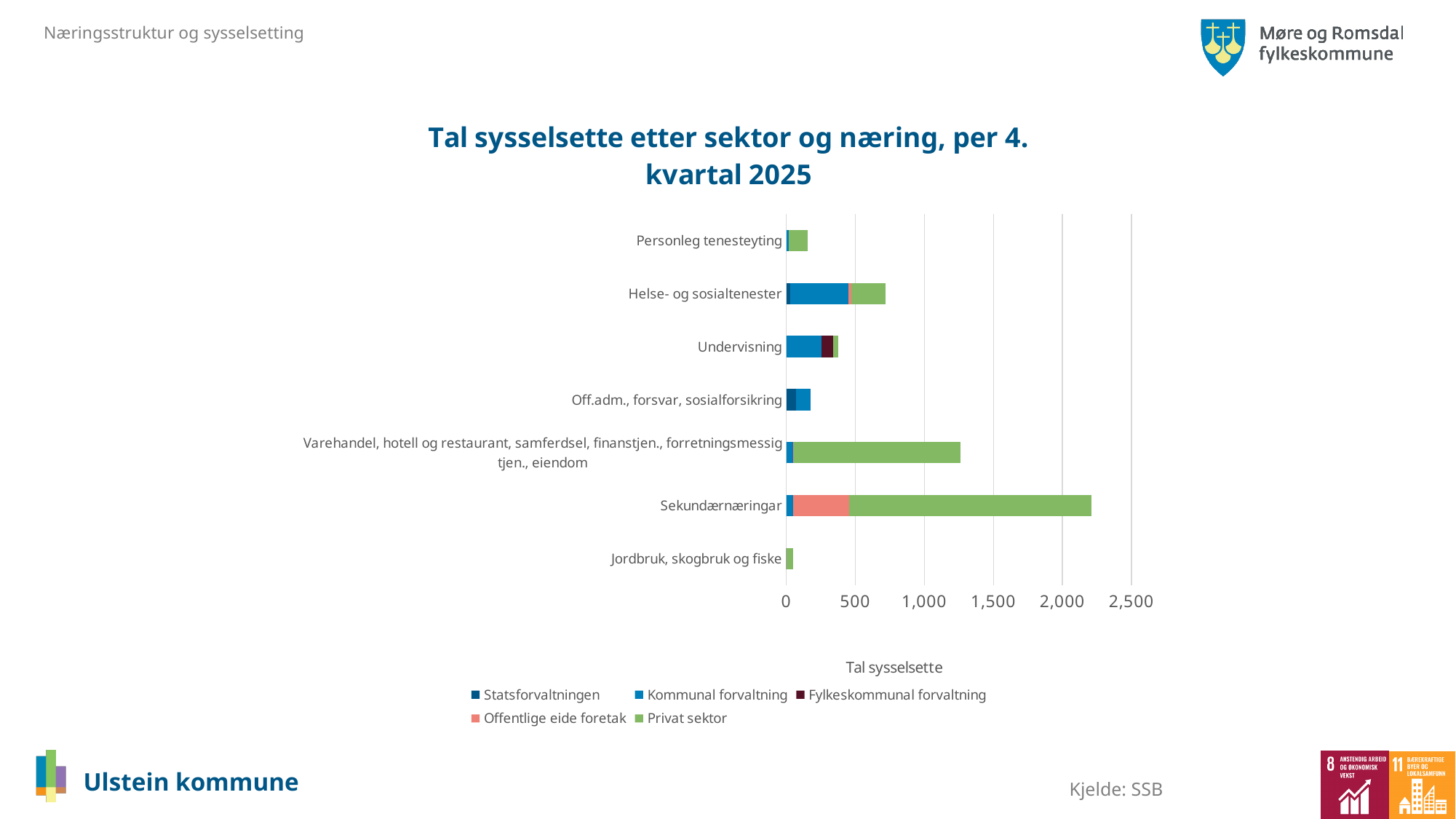
Is the total value for Varehandel, hotell og restaurant, samferdsel, finanstjen., forretningsmessig tjen., eiendom greater or less than 1,000? greater What is the title of the chart? Tal sysselsette etter sektor og næring, per 4. kvartal 2025 What kind of chart is shown on the slide? Stacked bar chart Which category has the longest total bar? Sekundærnæringar Is the total value for Undervisning greater or less than 500? less Which has the larger total bar: Helse- og sosialtenester or Varehandel, hotell og restaurant, samferdsel, finanstjen., forretningsmessig tjen., eiendom? Varehandel, hotell og restaurant, samferdsel, finanstjen., forretningsmessig tjen., eiendom Is the total value for Helse- og sosialtenester greater or less than 500? greater How many series does the chart legend list? 5 How many industry categories are shown on the y axis of the chart? 7 What is the label on the x axis of the chart? Tal sysselsette Which category has the shortest total bar? Jordbruk, skogbruk og fiske